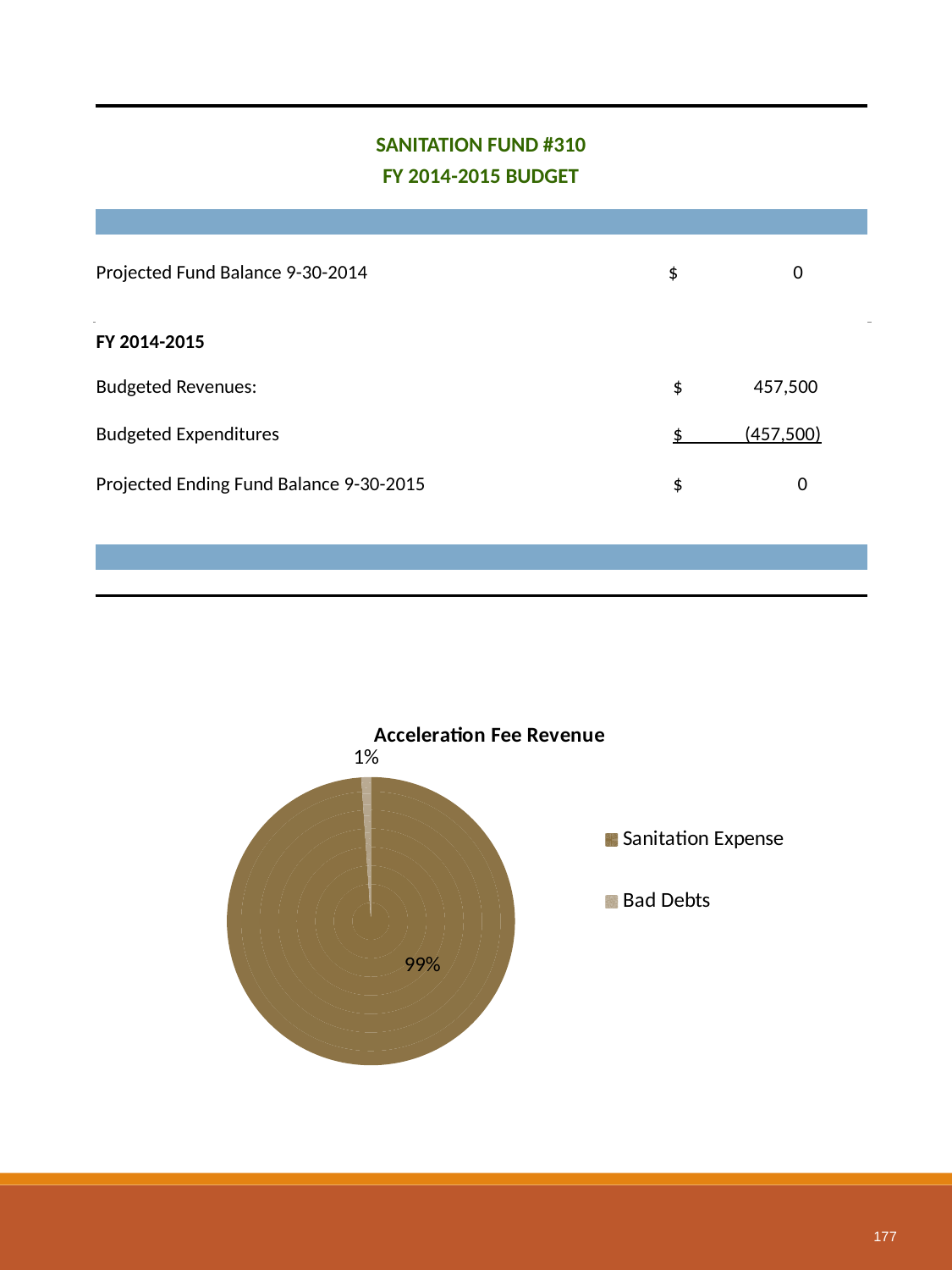
What share of the pie does Bad Debts represent? 1% Which is larger in the pie chart, Sanitation Expense or Bad Debts? Sanitation Expense Which slice of the pie chart is the largest? Sanitation Expense How many slices does the pie chart have? 2 Which legend entry is shown first in the pie chart's legend? Sanitation Expense How many entries does the legend of the pie chart list? 2 What is the title of the pie chart? Acceleration Fee Revenue What share of the pie does Sanitation Expense represent? 99% What is the difference in percentage points between the Sanitation Expense and Bad Debts slices? 98 What kind of chart is shown on the slide? pie chart Which slice of the pie chart is the smallest? Bad Debts